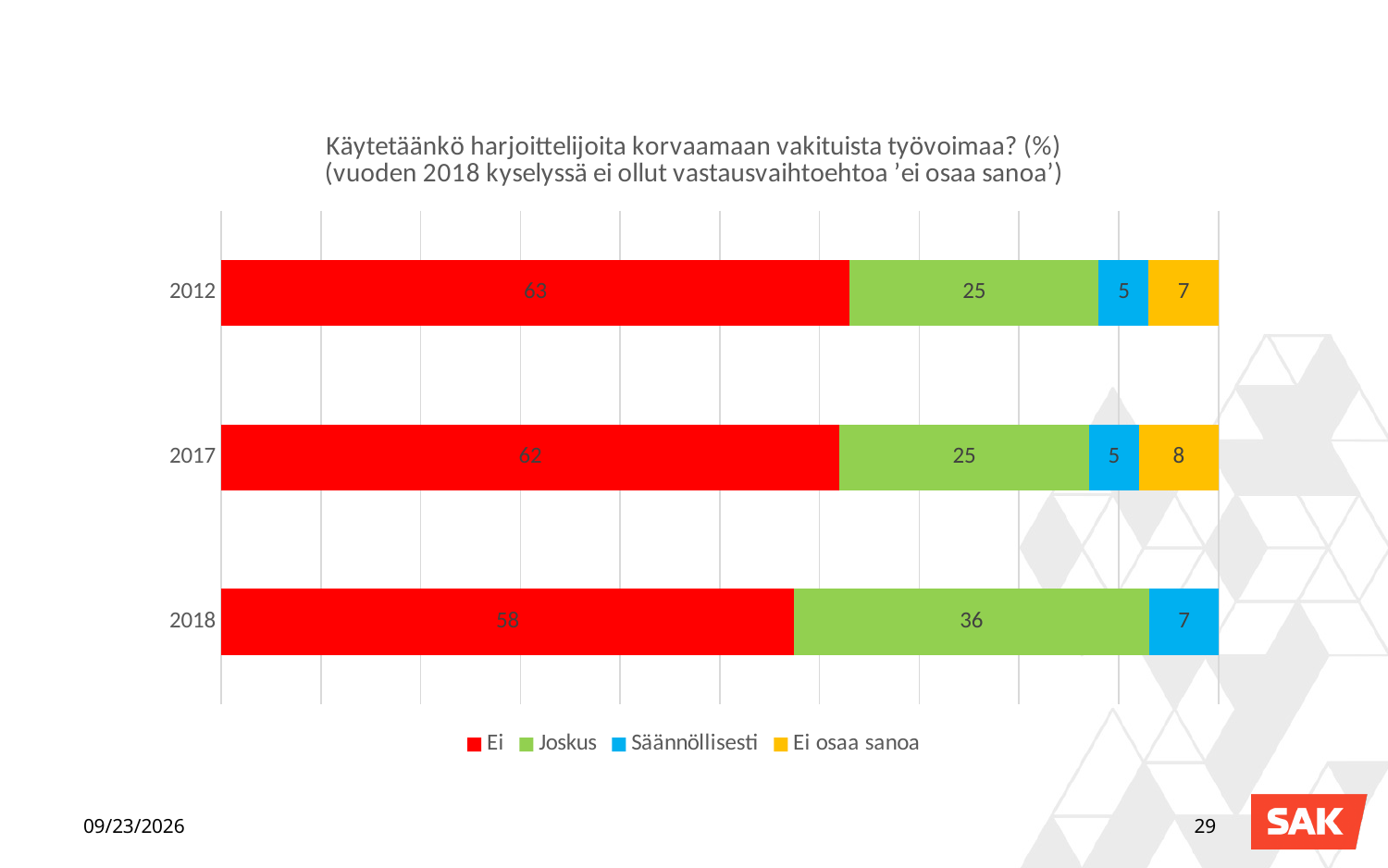
What is the value for 'Joskus' in 2018? 36 Is the 'Ei' value larger in 2017 or in 2018? 2017 Which year has the highest value for 'Ei'? 2012 What kind of chart is shown on the slide? Stacked bar chart Which year has the lowest value for 'Ei'? 2018 How many series does the legend list? 4 How many years are shown on the chart? 3 What is the value for 'Säännöllisesti' in 2018? 7 What is the difference between the 'Joskus' values for 2018 and 2017? 11 What is the total of the stacked bar for 2017? 100 What is the value for 'Ei osaa sanoa' in 2017? 8 What is the value for 'Ei' in 2012? 63